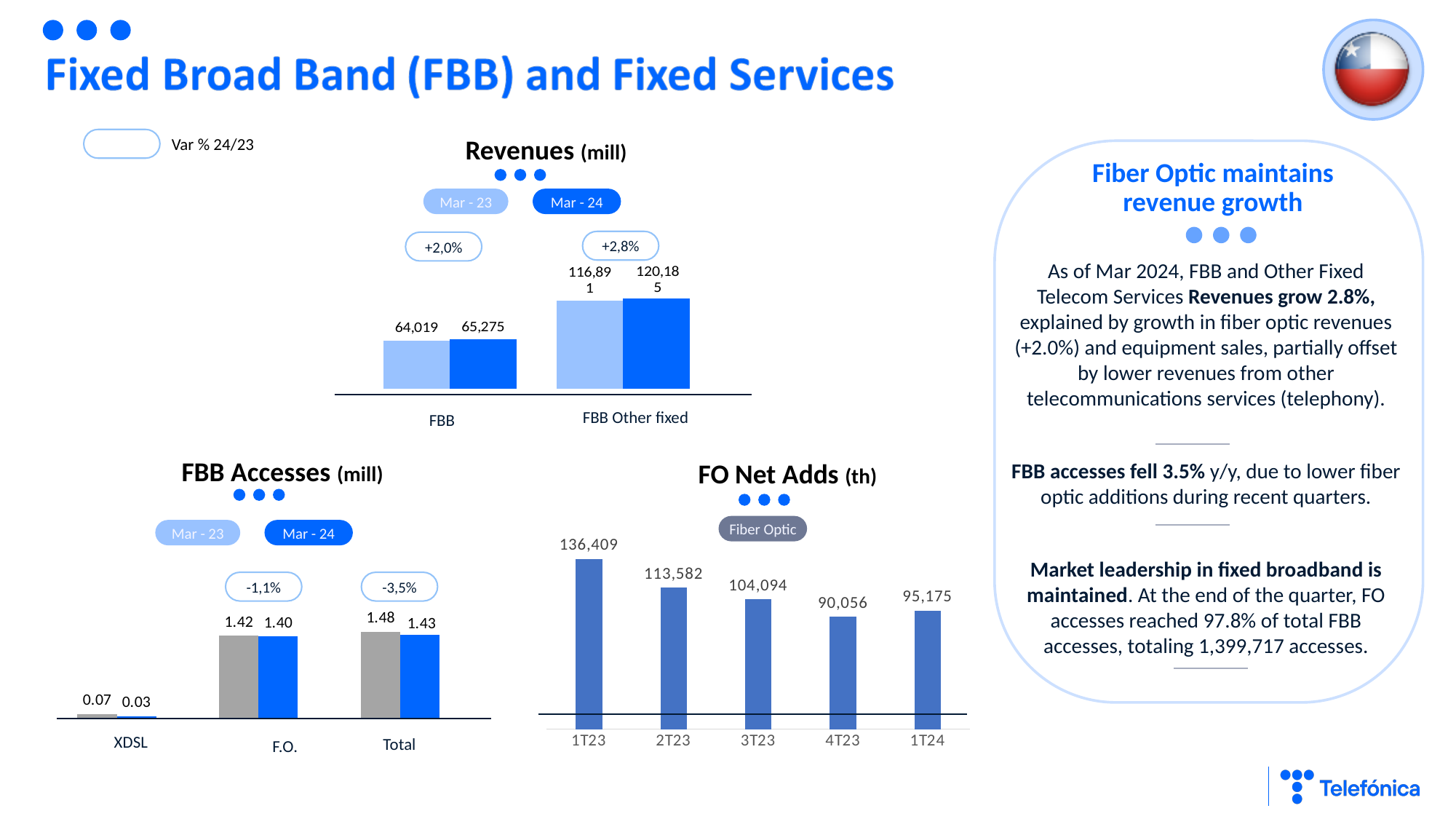
In the FBB Accesses (mill) chart, how many categories are shown on the x axis? 3 In the FO Net Adds (th) chart, which is larger, the value for 1T24 or the value for 4T23? 1T24 In the Revenues (mill) chart, what is the FBB revenue for Mar - 24? 65,275 In the Revenues (mill) chart, what is the difference between the Mar - 24 and Mar - 23 FBB revenue values? 1,256 In the FBB Accesses (mill) chart, what is the Total value for Mar - 24? 1.43 What kind of chart is the FO Net Adds (th) chart? Bar chart In the FO Net Adds (th) chart, which quarter has the highest value? 1T23 In the FBB Accesses (mill) chart, what is the F.O. value for Mar - 23? 1.42 In the Revenues (mill) chart, how many series does the legend list? 2 In the FO Net Adds (th) chart, what is the value for 4T23? 90,056 In the Revenues (mill) chart, what is the FBB revenue for Mar - 23? 64,019 In the FBB Accesses (mill) chart, which category has the lowest values? XDSL